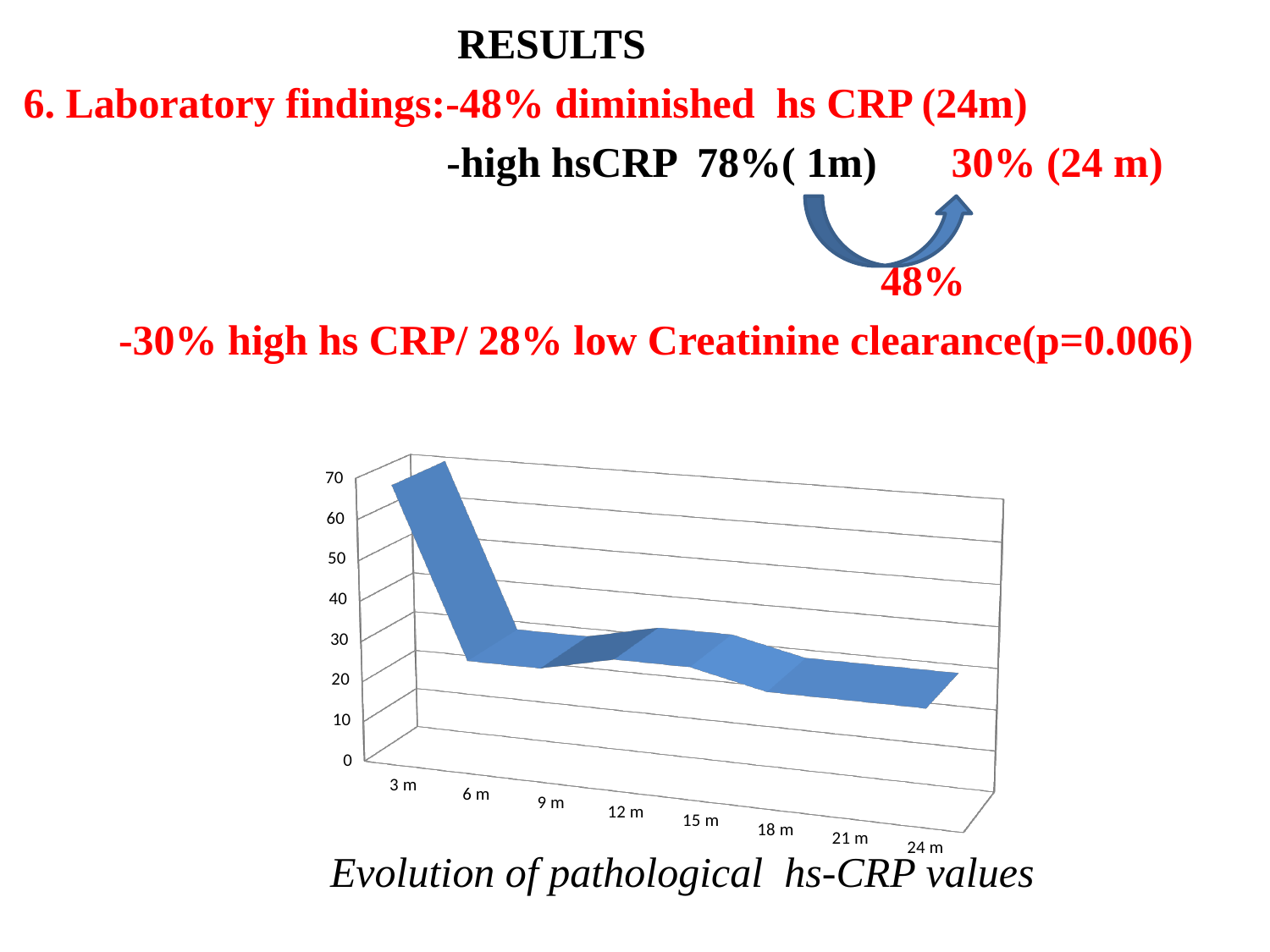
At which time point is the pathological hs-CRP value highest? 3 m Is the value at 18 m greater or less than 40? less What kind of chart is shown on the slide? 3D line chart What is the title of the chart? Evolution of pathological hs-CRP values Which is larger, the value at 3 m or the value at 6 m? 3 m Is the value at 3 m greater or less than 50? greater How many time points are shown on the x axis of the chart? 8 Is the value at 12 m greater or less than 50? less Which is larger, the value at 3 m or the value at 24 m? 3 m Do the values rise or fall from 3 m to 24 m along the x axis? fall